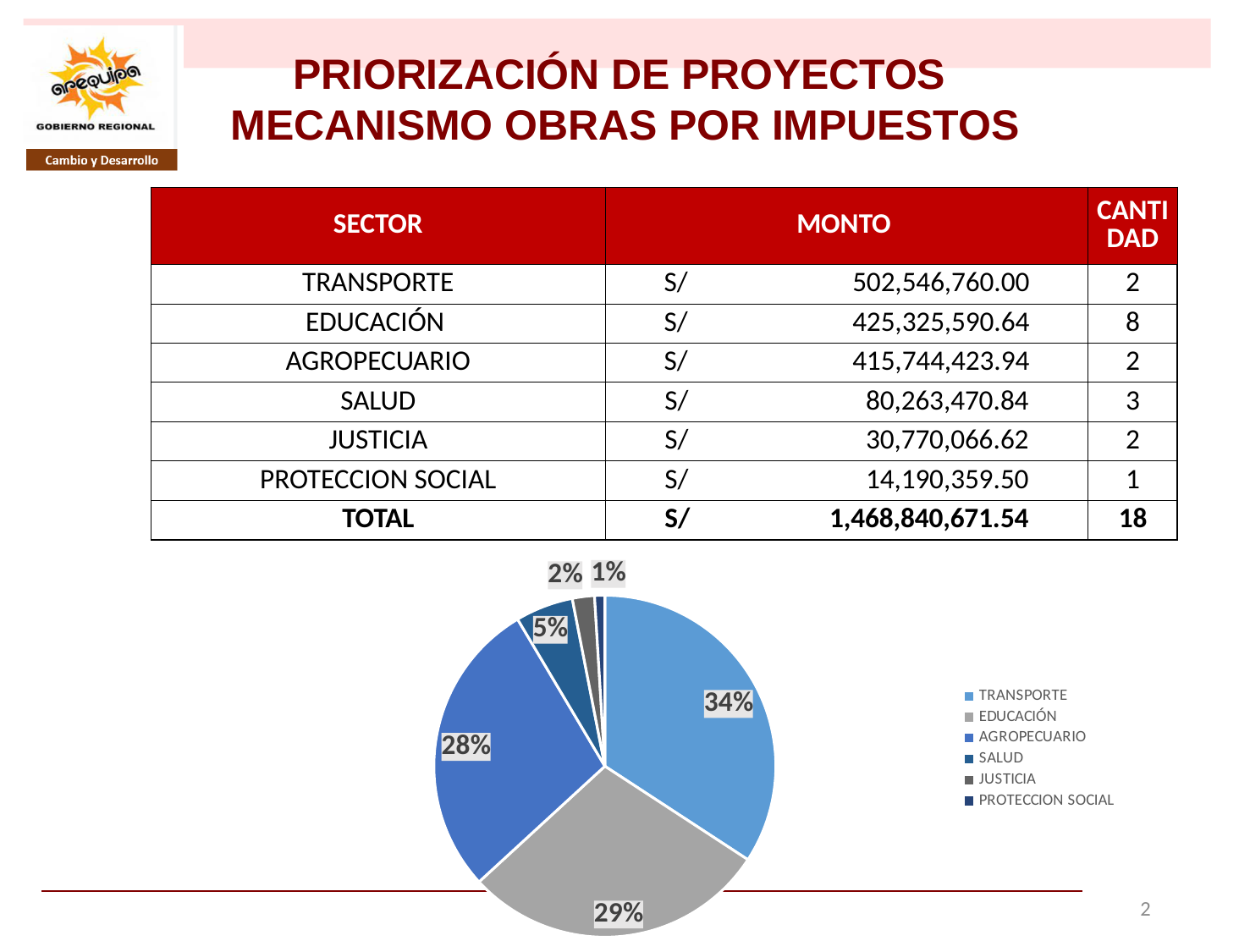
What kind of chart is shown on the slide? pie chart Which sector is shown in grey in the pie chart? EDUCACIÓN What is the difference in percentage points between the TRANSPORTE slice and the SALUD slice? 29 Which sector has the largest slice in the pie chart? TRANSPORTE What share of the pie chart does TRANSPORTE represent? 34% What share of the pie chart does EDUCACIÓN represent? 29% What share of the pie chart does SALUD represent? 5% How many sectors does the pie chart legend list? 6 Which slice is larger in the pie chart, JUSTICIA or SALUD? SALUD Which sector has the smallest slice in the pie chart? PROTECCION SOCIAL